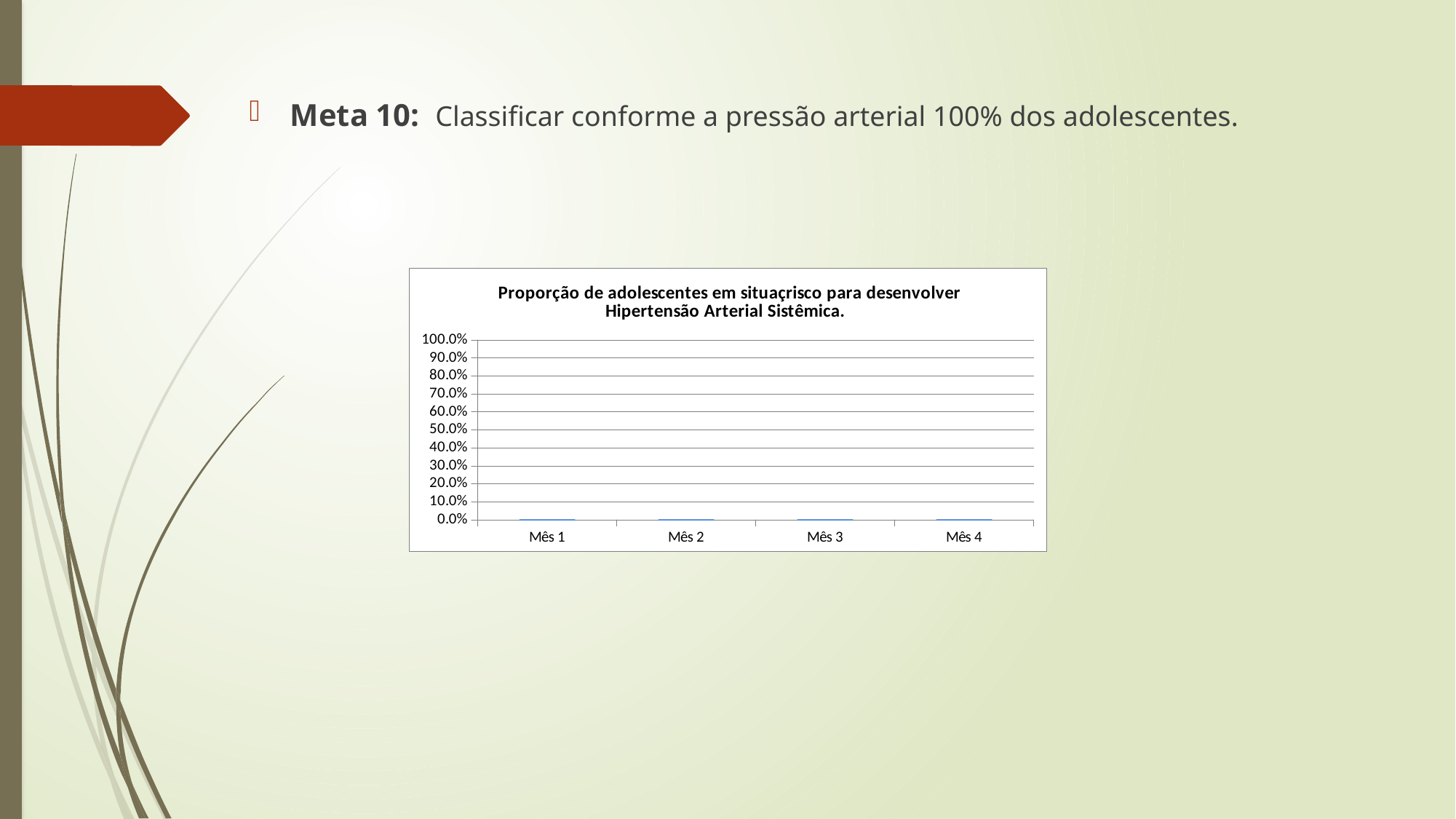
What kind of chart is shown on the slide? bar chart What is the highest value shown on the y axis of the chart? 100.0% Is the value for Mês 4 greater or less than 50.0%? less Do the values rise, fall, or stay flat from Mês 1 to Mês 4? stay flat Is the value for Mês 2 greater or less than 10.0%? less What value does the bar for Mês 4 land on? 0.0% How many categories are shown on the x axis of the chart? 4 What is the label of the first category on the x axis? Mês 1 What value does the bar for Mês 1 land on? 0.0% Is the value for Mês 3 greater or less than 20.0%? less